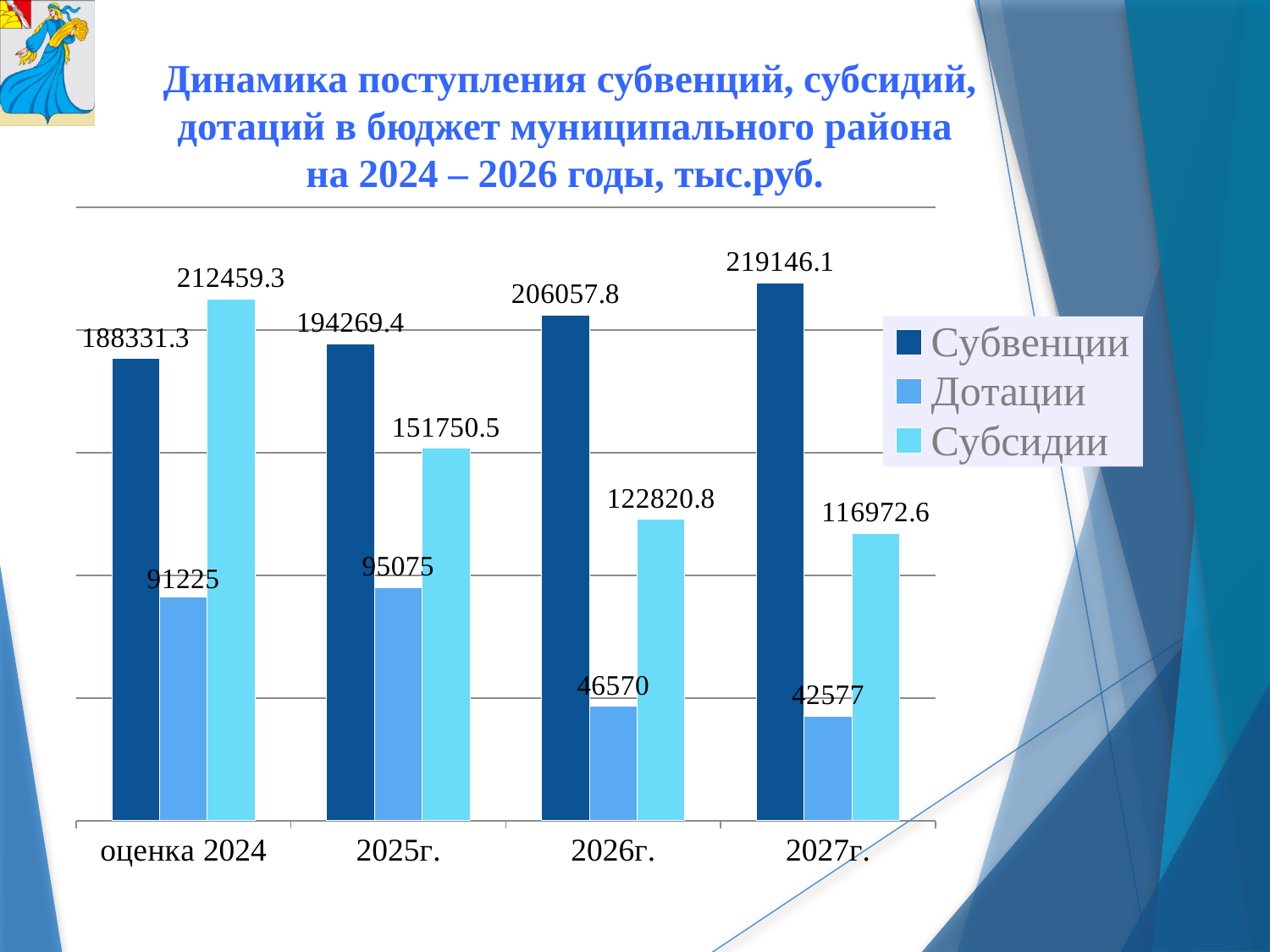
What is the value of Субсидии for 2025г.? 151750.5 In which category is Субвенции highest? 2027г. How many series does the legend list? 3 What is the value of Субсидии for 2026г.? 122820.8 What is the value of Субвенции for 2027г.? 219146.1 What is the value of Дотации for оценка 2024? 91225 How many categories are shown on the x axis? 4 What is the difference between Субсидии and Субвенции for оценка 2024? 24128 Do the values of Субсидии rise or fall from оценка 2024 to 2027г.? fall What kind of chart is shown on the slide? bar chart In which category is Дотации lowest? 2027г. Which is larger for 2026г.: Субвенции or Субсидии? Субвенции